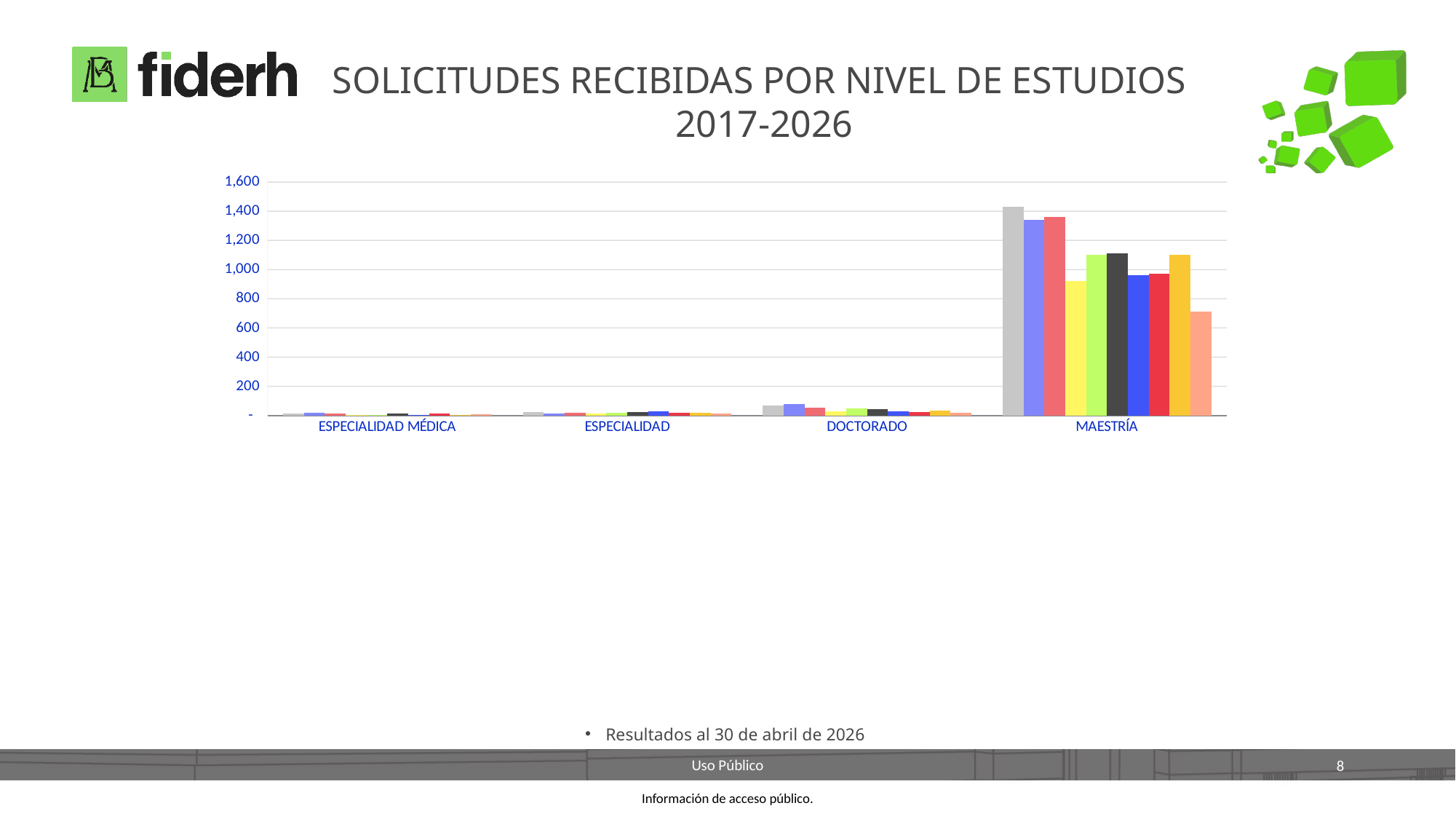
How many categories are shown on the x axis of the chart? 4 What is the title of the chart on the slide? SOLICITUDES RECIBIDAS POR NIVEL DE ESTUDIOS 2017-2026 How many bars are plotted for the MAESTRÍA category? 10 Are all the bars for DOCTORADO greater or less than 200? less Is the value of the yellow bar for MAESTRÍA greater or less than 1,000? less Which category has larger values, MAESTRÍA or DOCTORADO? MAESTRÍA What is the highest value shown on the vertical axis of the chart? 1,600 Is the value of the last (salmon) bar for MAESTRÍA greater or less than 800? less Do the values generally rise or fall moving from ESPECIALIDAD MÉDICA to MAESTRÍA along the x axis? rise Which category has the highest values in the chart? MAESTRÍA What kind of chart is shown on the slide? bar chart